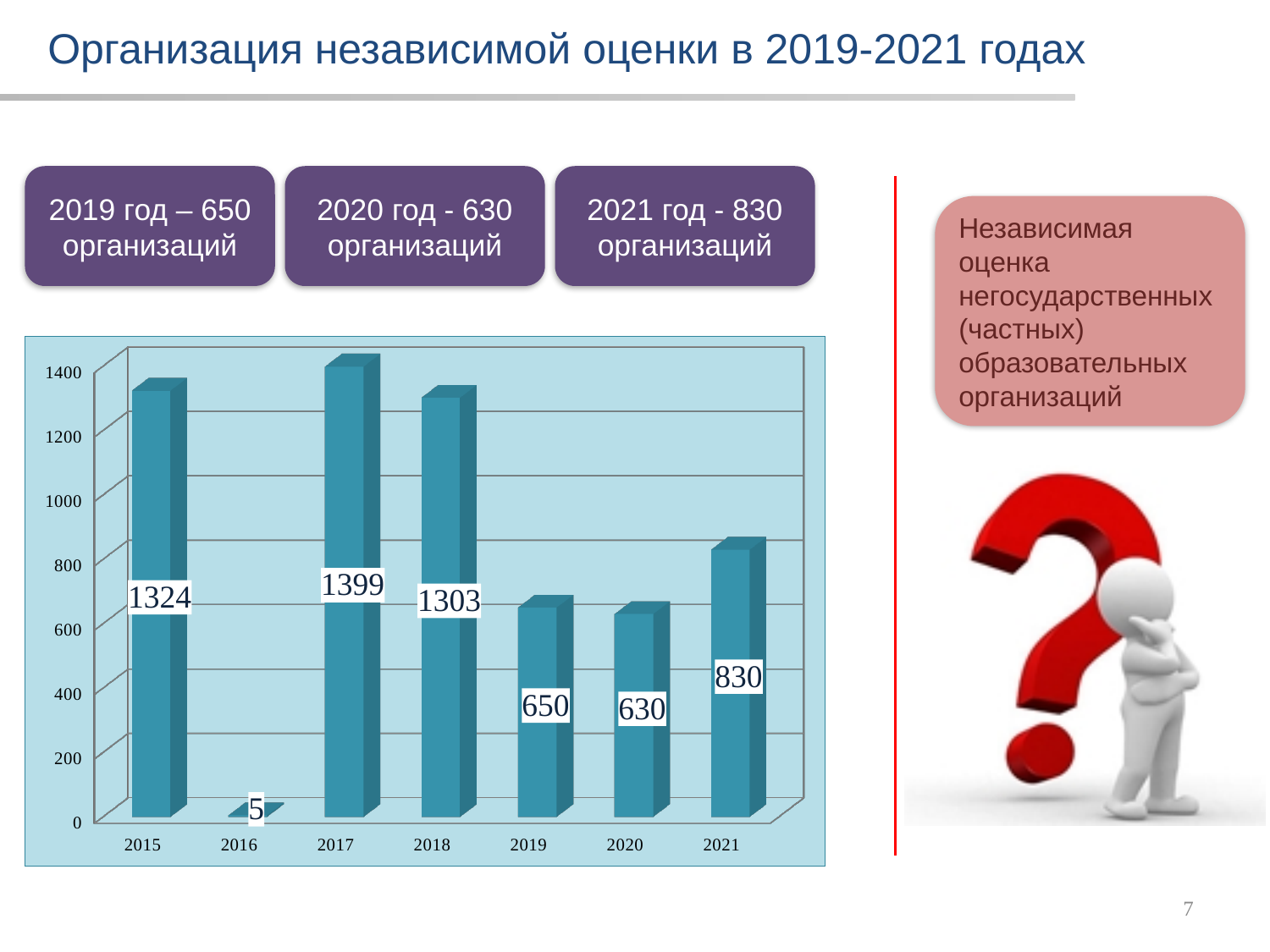
What kind of chart is shown on the slide? bar chart What is the value for 2017? 1399 What is the difference between the values for 2021 and 2020? 200 Which is larger, the value for 2019 or the value for 2021? 2021 What is the value for 2021? 830 Is the value for 2018 greater or less than 1200? greater How many years are shown on the x axis? 7 What is the difference between the values for 2017 and 2018? 96 Which year has the lowest value? 2016 Which year has the highest value? 2017 What is the value for 2015? 1324